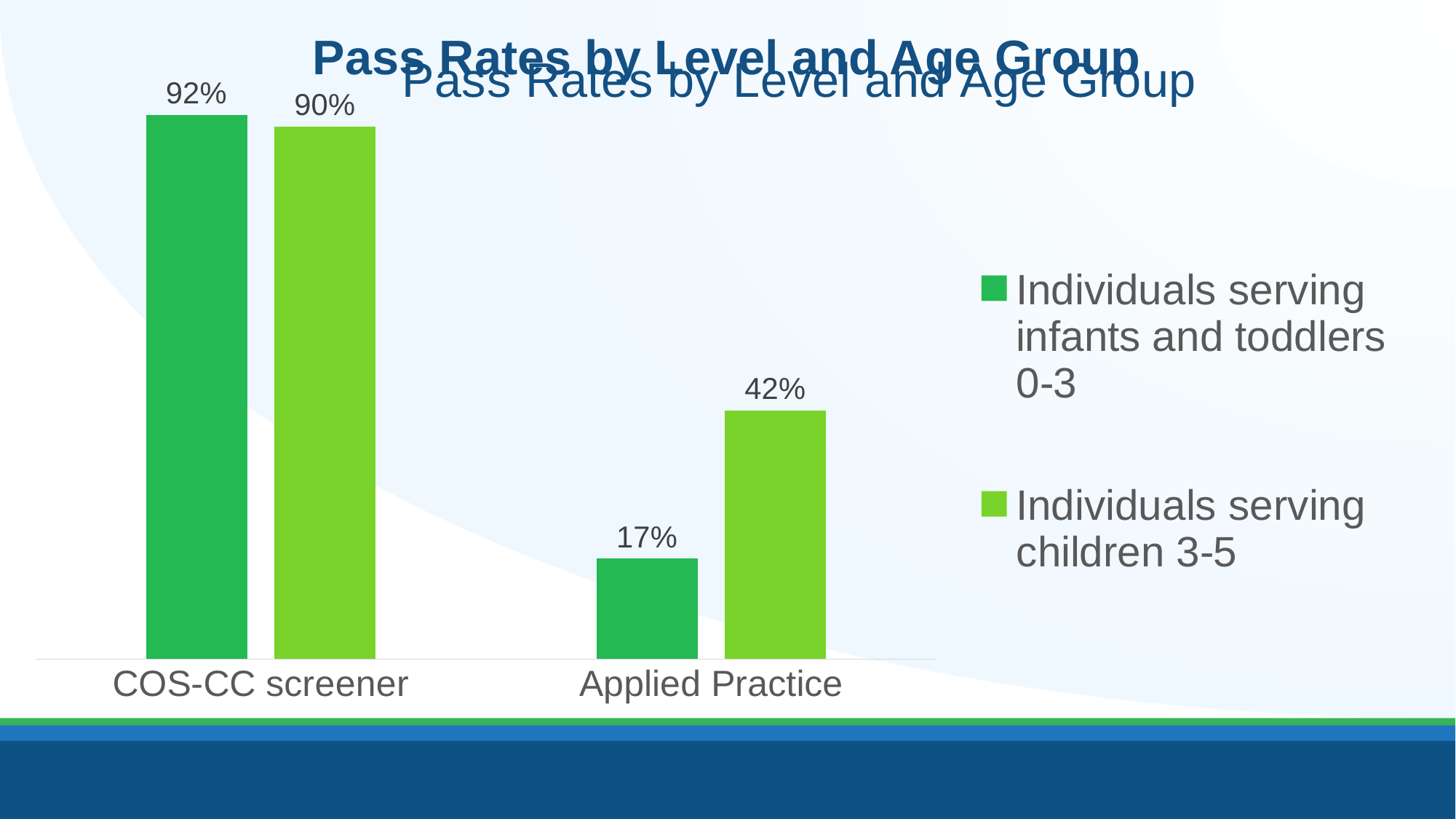
What kind of chart is shown on the slide? Bar chart What is the difference between the COS-CC screener pass rates for individuals serving infants and toddlers 0-3 and individuals serving children 3-5? 2% How many series does the legend list? 2 Which level has the lowest pass rate for individuals serving infants and toddlers 0-3? Applied Practice What is the pass rate for individuals serving children 3-5 on Applied Practice? 42% What is the difference between the Applied Practice pass rates for individuals serving children 3-5 and individuals serving infants and toddlers 0-3? 25% What is the pass rate for individuals serving infants and toddlers 0-3 on the COS-CC screener? 92% What is the pass rate for individuals serving infants and toddlers 0-3 on Applied Practice? 17% How many levels are shown on the x axis of the chart? 2 Which level has the highest pass rate for individuals serving children 3-5? COS-CC screener What is the pass rate for individuals serving children 3-5 on the COS-CC screener? 90% On Applied Practice, which group has the higher pass rate: individuals serving infants and toddlers 0-3 or individuals serving children 3-5? Individuals serving children 3-5